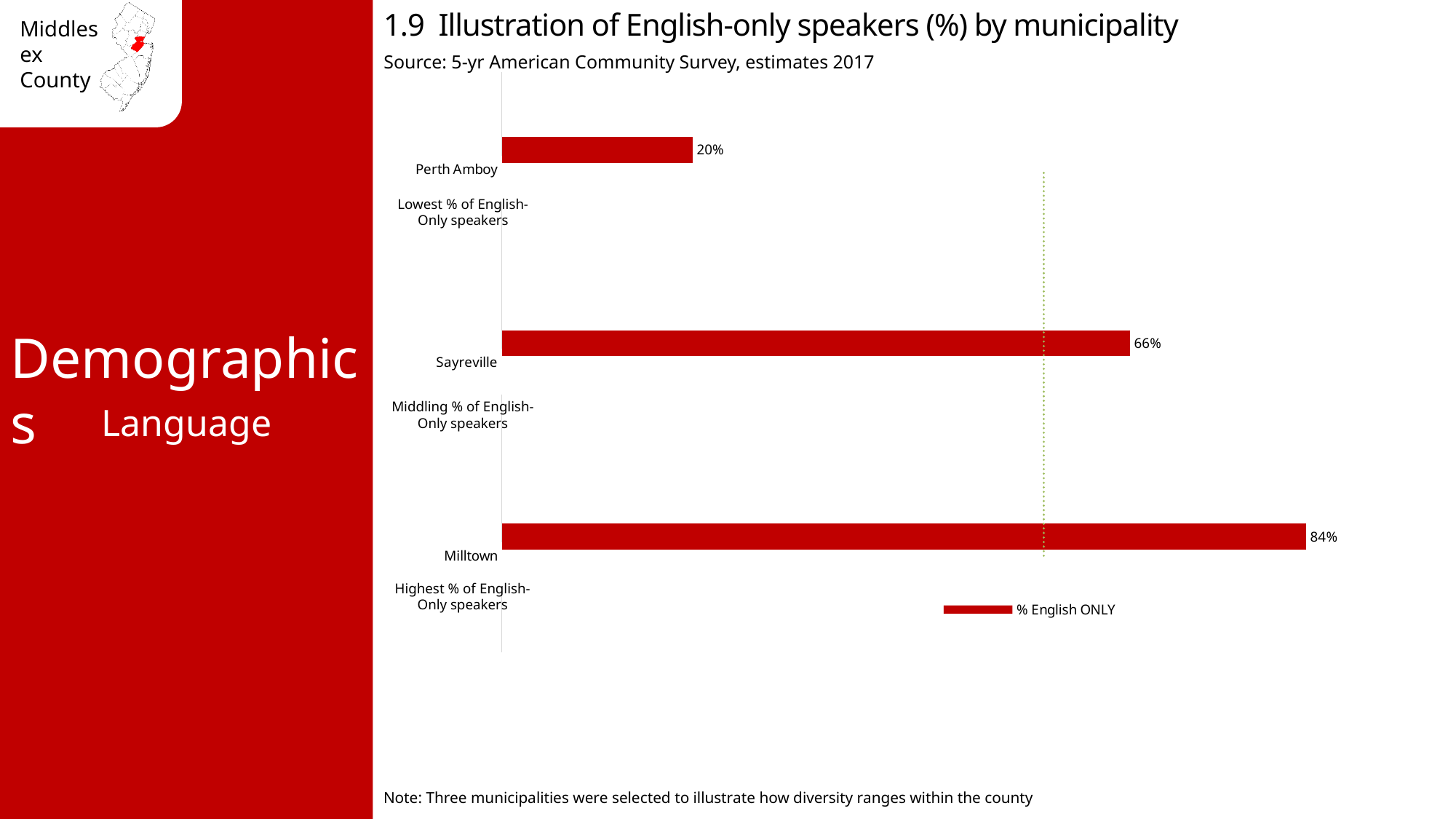
What is the difference in percentage points between Milltown and Perth Amboy? 64 Which municipality has the lowest percentage of English-only speakers? Perth Amboy What is the legend entry for the series shown in the chart? % English ONLY Which municipality has the highest percentage of English-only speakers? Milltown What is the difference in percentage points between Sayreville and Perth Amboy? 46 How many series does the legend list? 1 What is the percentage of English-only speakers in Milltown? 84% What is the percentage of English-only speakers in Sayreville? 66% How many municipalities are shown in the chart? 3 Which has a higher percentage of English-only speakers, Sayreville or Milltown? Milltown What is the percentage of English-only speakers in Perth Amboy? 20% What type of chart is shown on the slide? Bar chart